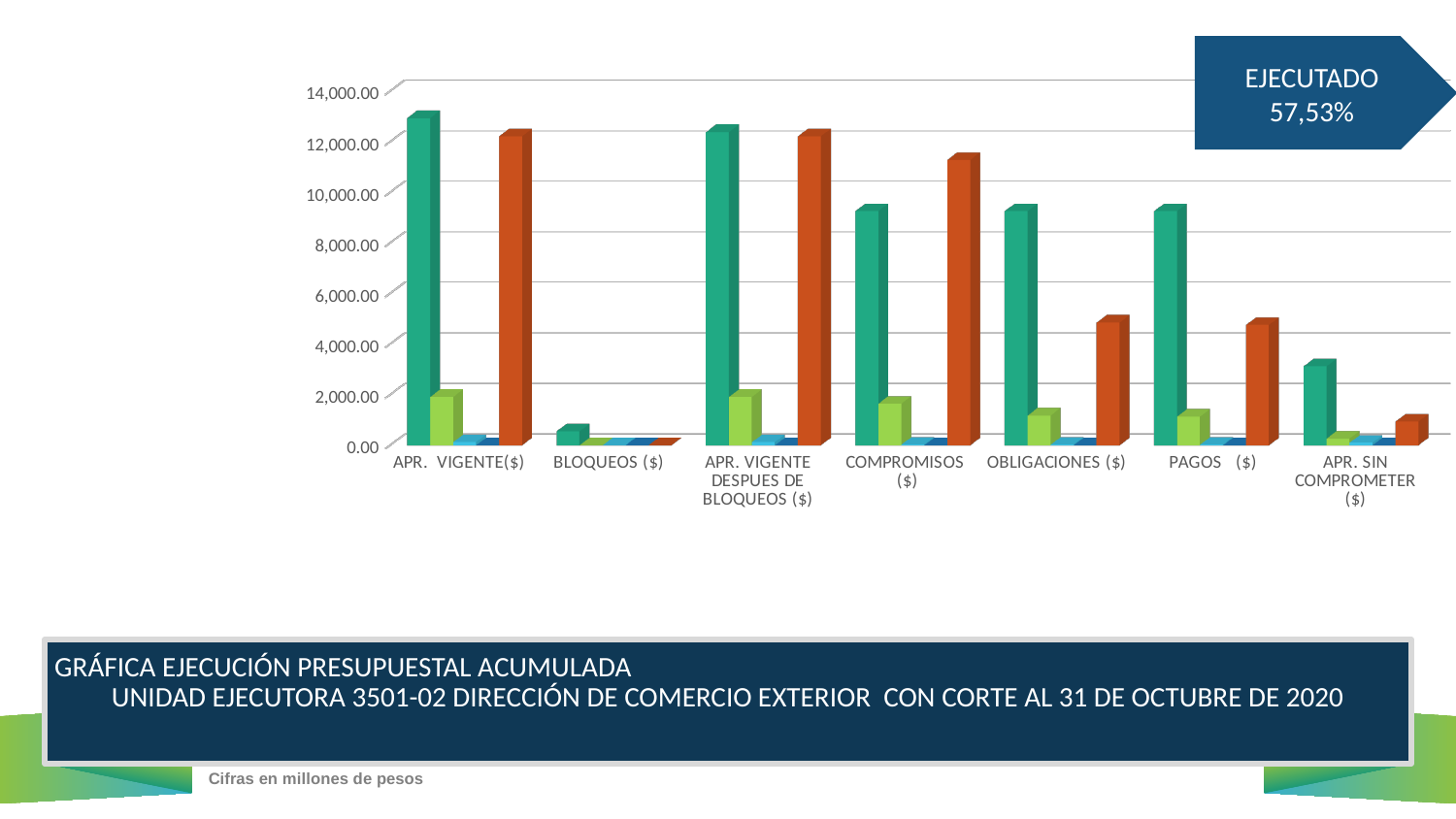
Is the orange bar for OBLIGACIONES ($) greater or less than 6,000.00? less Is the orange bar for COMPROMISOS ($) greater or less than 10,000.00? greater Which category has the tallest teal bar? APR. VIGENTE($) Is the teal bar for APR. VIGENTE($) greater or less than 12,000.00? greater Which is larger: the teal bar for COMPROMISOS ($) or the teal bar for APR. SIN COMPROMETER ($)? COMPROMISOS ($) How many categories are shown along the x axis of the chart? 7 What percentage is shown in the EJECUTADO callout on the slide? 57,53% What kind of chart is shown on the slide? bar chart According to the note at the bottom of the slide, in what units are the figures expressed? Cifras en millones de pesos Which category has the shortest teal bar? BLOQUEOS ($)